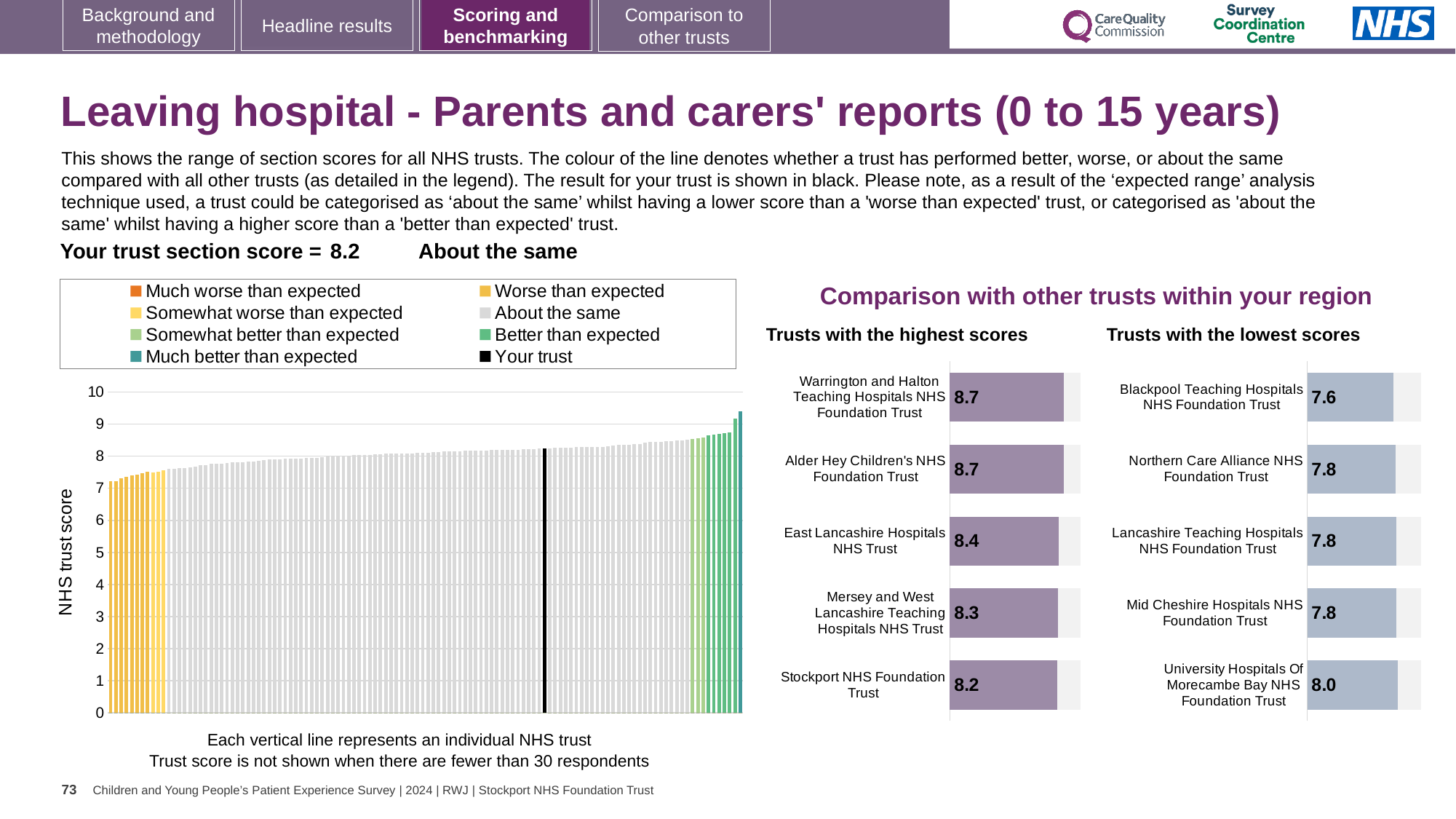
In the 'Trusts with the highest scores' chart, which trust has the lowest score? Stockport NHS Foundation Trust In the large chart on the left showing the range of section scores, do the trust scores rise or fall from left to right? rise In the 'Trusts with the lowest scores' chart, what is the difference between the scores of University Hospitals Of Morecambe Bay NHS Foundation Trust and Blackpool Teaching Hospitals NHS Foundation Trust? 0.4 In the 'Trusts with the highest scores' chart, what is the difference between the scores of Warrington and Halton Teaching Hospitals NHS Foundation Trust and Stockport NHS Foundation Trust? 0.5 What kind of chart is the 'Trusts with the highest scores' chart? bar chart In the 'Trusts with the highest scores' chart, what is the score for East Lancashire Hospitals NHS Trust? 8.4 In the 'Trusts with the highest scores' chart, what is the score for Warrington and Halton Teaching Hospitals NHS Foundation Trust? 8.7 In the large chart on the left showing the range of section scores, how many entries does the legend list? 8 In the 'Trusts with the lowest scores' chart, how many trusts are shown? 5 In the 'Trusts with the lowest scores' chart, which trust has the lowest score? Blackpool Teaching Hospitals NHS Foundation Trust In the 'Trusts with the lowest scores' chart, which trust has the highest score? University Hospitals Of Morecambe Bay NHS Foundation Trust In the 'Trusts with the lowest scores' chart, what is the score for Blackpool Teaching Hospitals NHS Foundation Trust? 7.6